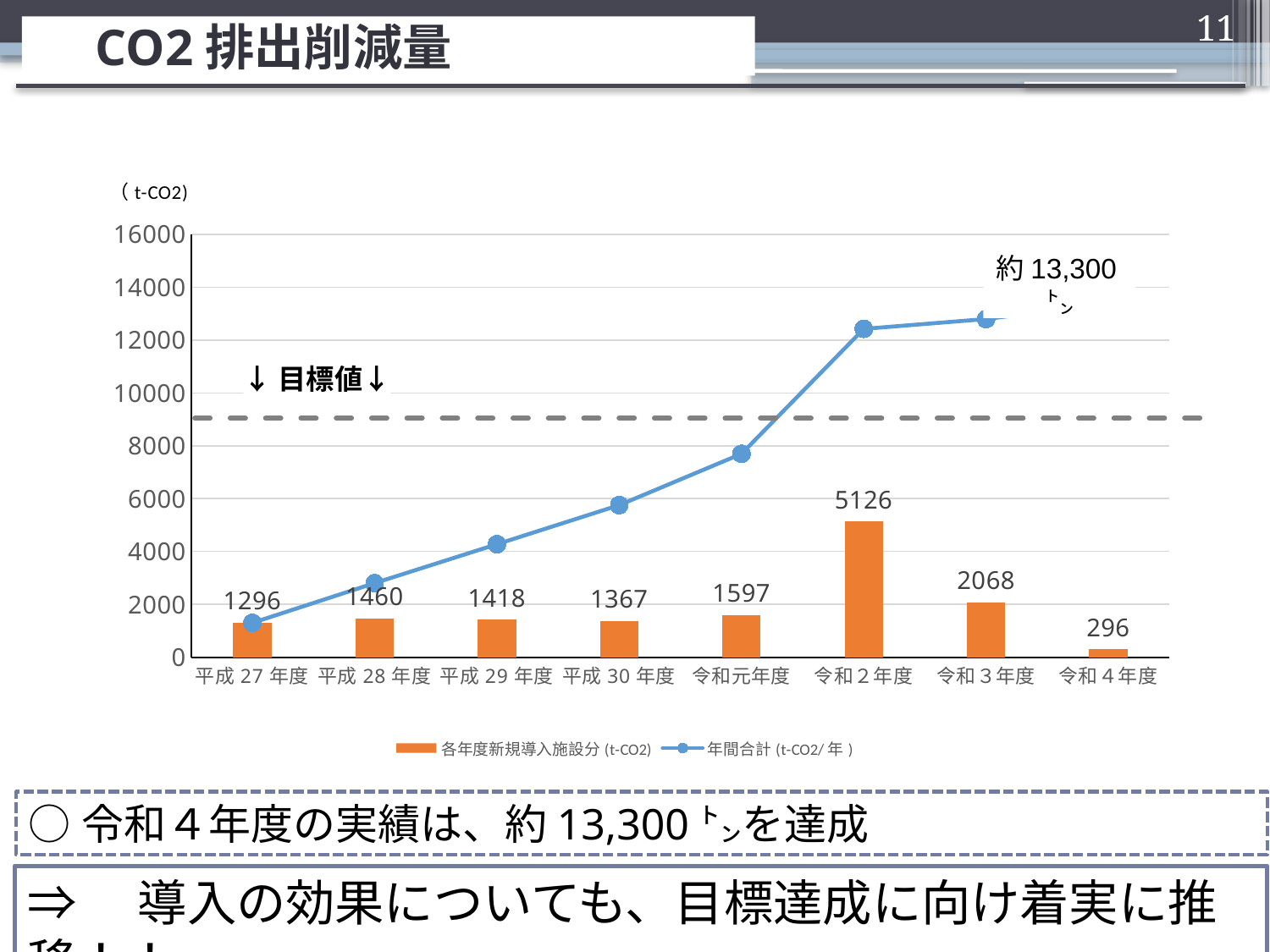
What is the value of the bar for 令和２年度? 5126 How many series does the legend list? 2 How many fiscal years are shown on the x axis? 8 Is the 年間合計 line value for 令和元年度 greater or less than 8000? less What is the value of the bar for 平成 27 年度? 1296 Does the 年間合計 line rise or fall from 平成 27 年度 to 令和４年度? rise What is the value of the bar for 令和３年度? 2068 Which bar is larger, 平成 28 年度 or 平成 30 年度? 平成 28 年度 Which year has the highest bar value? 令和２年度 What is the difference between the bar values for 令和２年度 and 令和３年度? 3058 Is the 年間合計 line value for 令和２年度 greater or less than 12000? greater Which year has the lowest bar value? 令和４年度